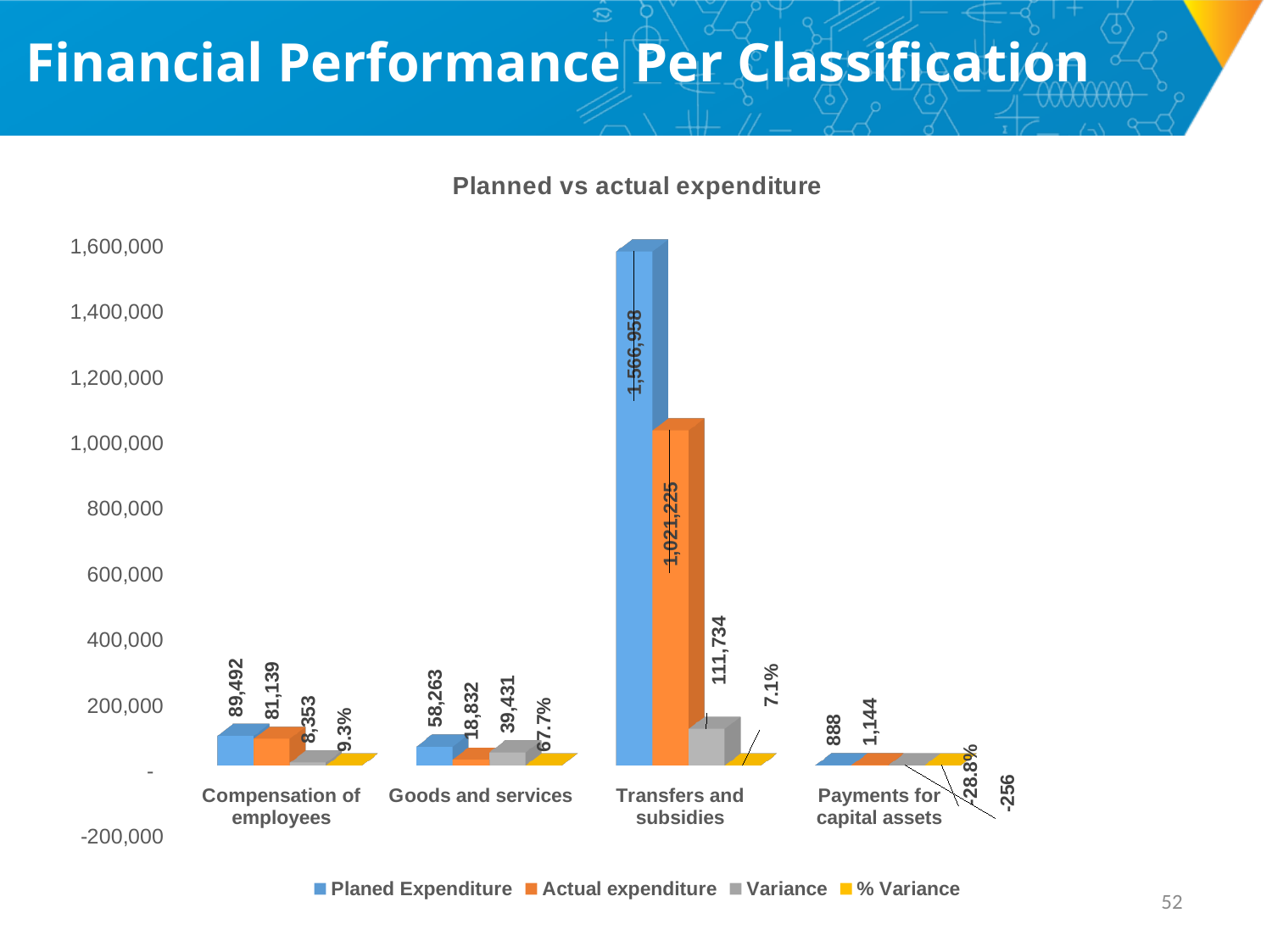
Which is larger for Payments for capital assets: Planed Expenditure or Actual expenditure? Actual expenditure Which category has the highest Planed Expenditure? Transfers and subsidies What type of chart is shown? Bar chart How many categories are shown on the x axis? 4 How many series does the legend list? 4 What is the % Variance for Compensation of employees? 9.3% What is the Planed Expenditure value for Transfers and subsidies? 1,566,958 Which category has the lowest Actual expenditure? Payments for capital assets What is the Variance value for Payments for capital assets? -256 What is the difference between Planed Expenditure and Actual expenditure for Compensation of employees? 8,353 Is the Actual expenditure for Transfers and subsidies greater or less than 1,000,000? greater What is the Actual expenditure value for Goods and services? 18,832